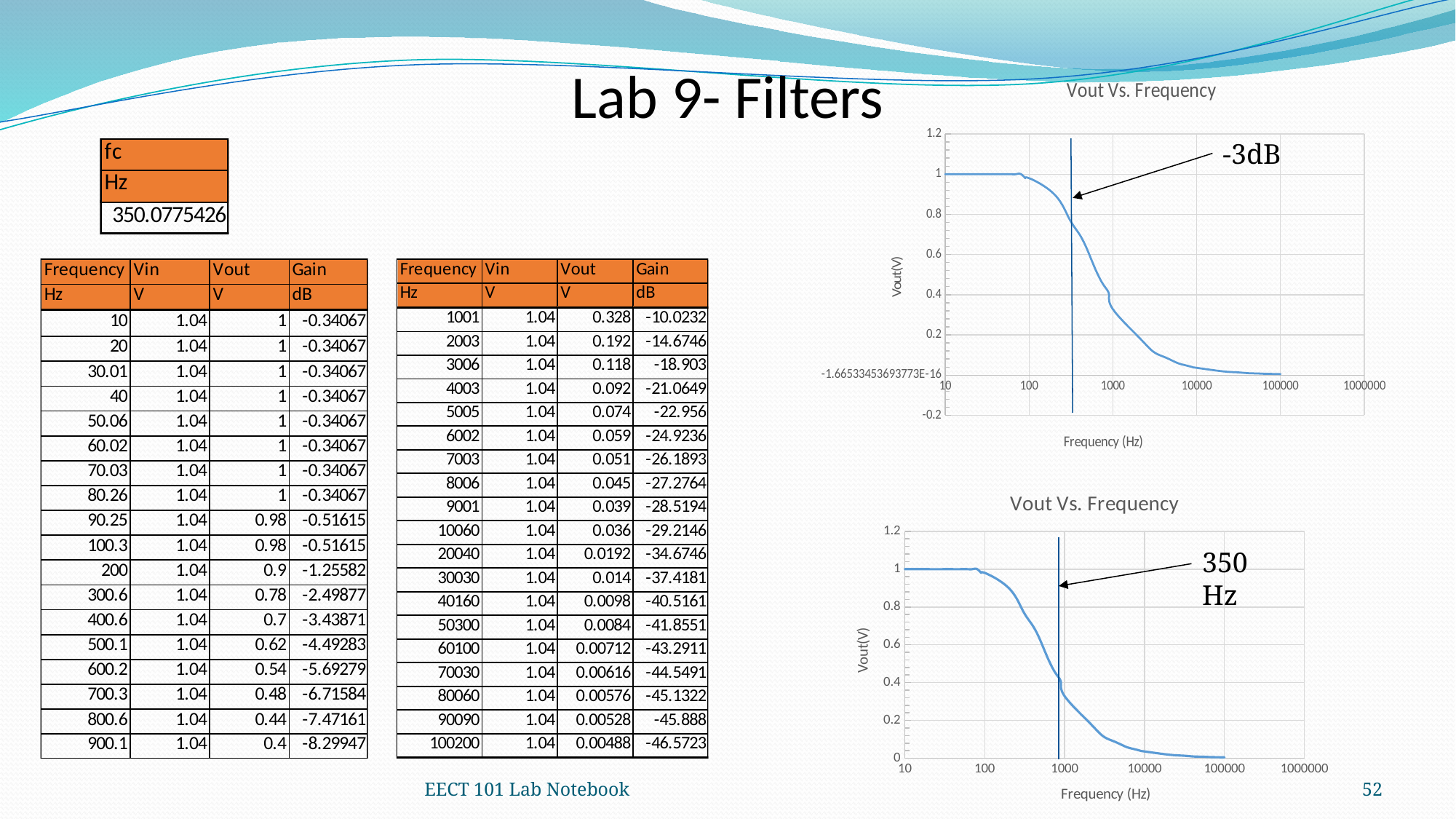
In the top 'Vout Vs. Frequency' chart, is the value at 10000 Hz greater or less than 0.2? less In the top 'Vout Vs. Frequency' chart, which has the larger Vout: 100 Hz or 1000 Hz? 100 Hz In the top 'Vout Vs. Frequency' chart, is the value at 10 Hz greater or less than 0.8? greater In the bottom 'Vout Vs. Frequency' chart, which has the larger Vout: 10 Hz or 10000 Hz? 10 Hz What text does the arrow annotation on the top 'Vout Vs. Frequency' chart point from? -3dB In the bottom 'Vout Vs. Frequency' chart, is the value at 100 Hz greater or less than 0.8? greater What is the y-axis label of the bottom 'Vout Vs. Frequency' chart? Vout(V) In the top 'Vout Vs. Frequency' chart, does Vout rise or fall as frequency increases along the x axis? fall In the bottom 'Vout Vs. Frequency' chart, does Vout rise or fall as frequency increases along the x axis? fall What kind of chart is the top 'Vout Vs. Frequency' chart? line chart